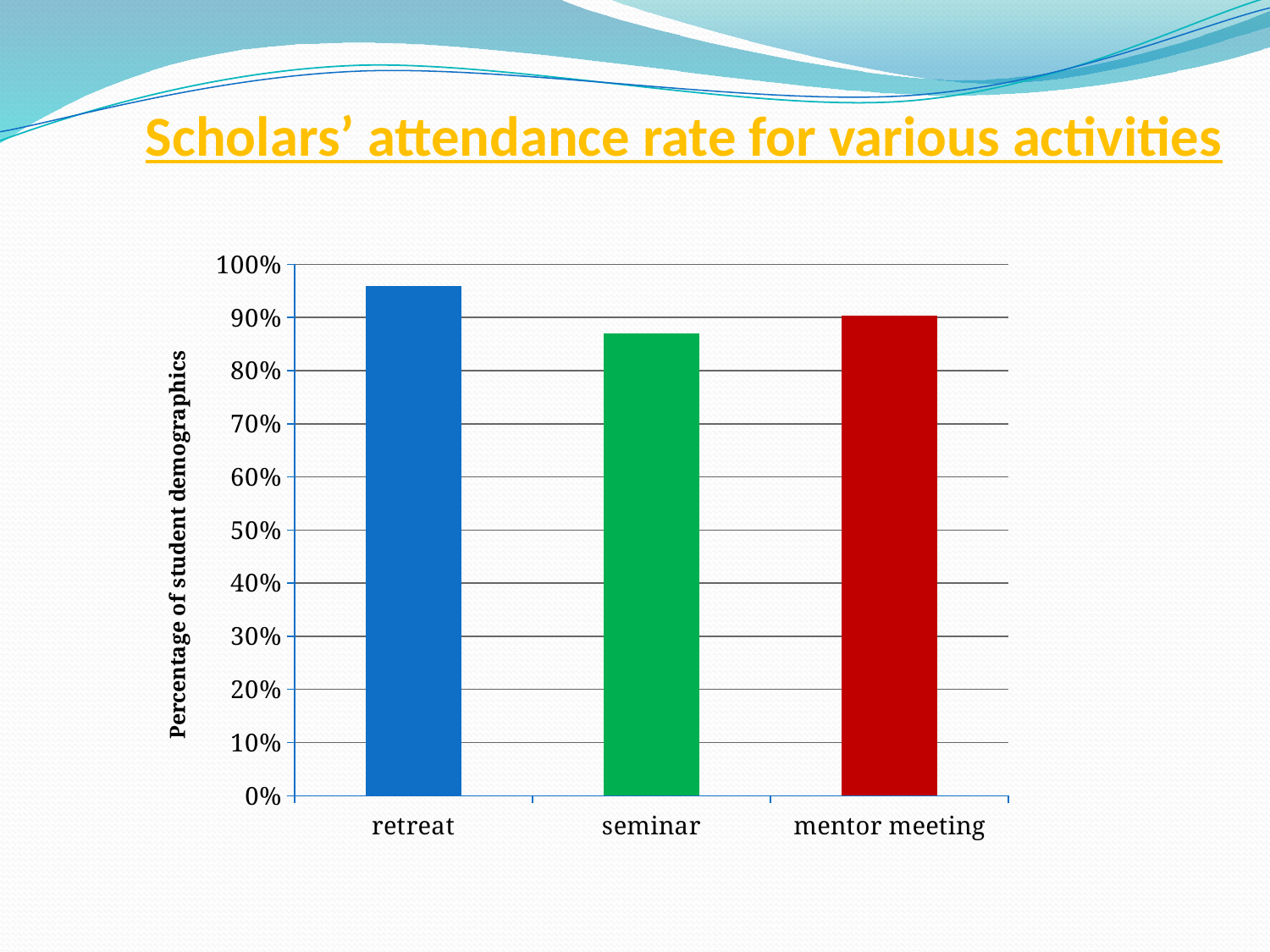
What is the title of the chart on the slide? Scholars' attendance rate for various activities Is the attendance rate for seminar greater or less than 90%? less Which has a higher attendance rate, retreat or mentor meeting? retreat What kind of chart is shown on the slide? bar chart Which activity has the lowest attendance rate? seminar How many activities are shown on the x axis of the chart? 3 Which has a higher attendance rate, retreat or seminar? retreat What is the label of the y axis on the chart? Percentage of student demographics Is the attendance rate for seminar greater or less than 80%? greater Is the attendance rate for mentor meeting greater or less than 80%? greater Which activity has the highest attendance rate? retreat